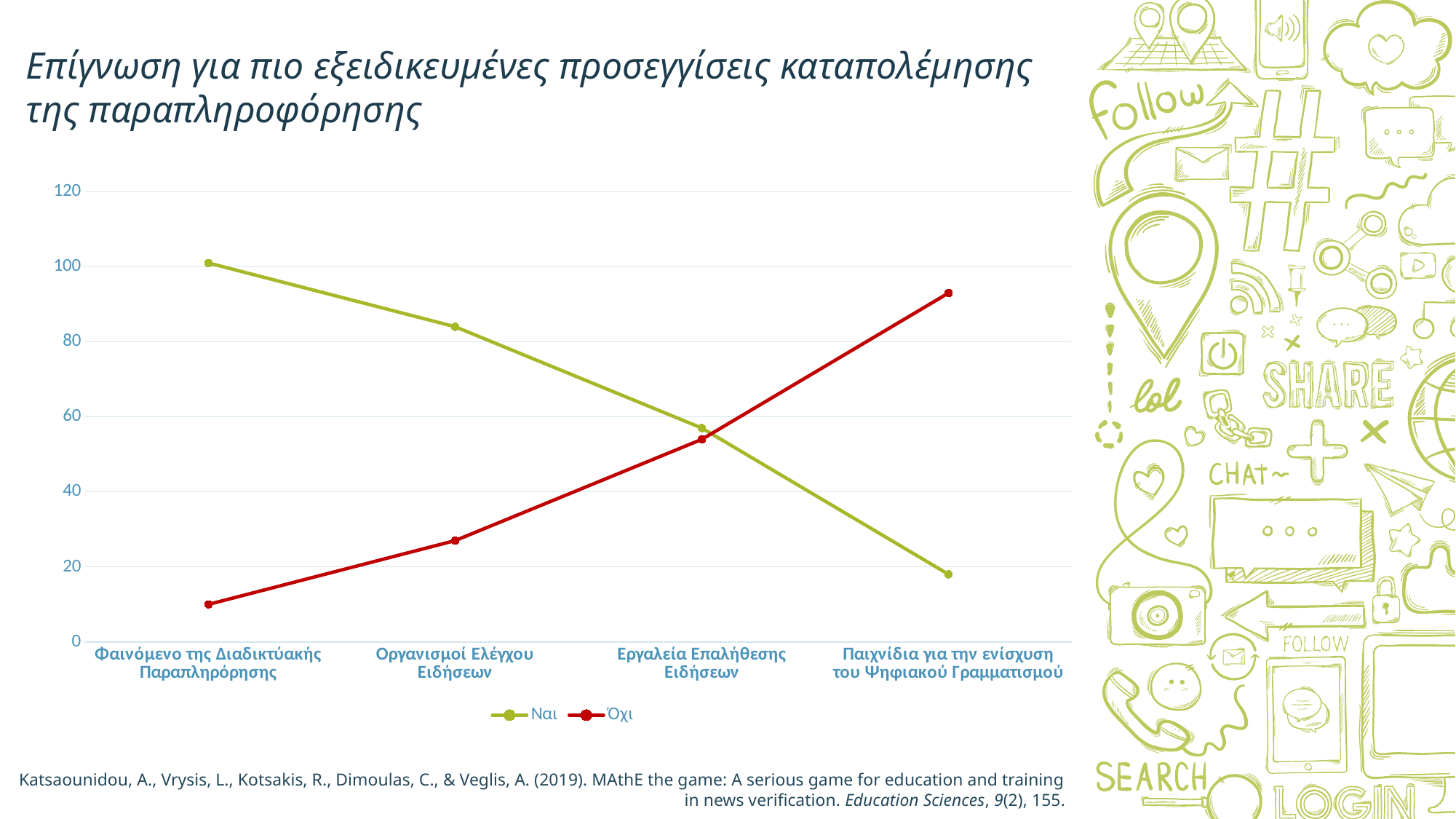
How many categories are shown on the x axis? 4 Is the Όχι value for Οργανισμοί Ελέγχου Ειδήσεων greater or less than 40? less For which category is the Ναι value highest? Φαινόμενο της Διαδικτυακής Παραπληρόρησης For which category is the Όχι value highest? Παιχνίδια για την ενίσχυση του Ψηφιακού Γραμματισμού Which series is shown in green in the legend? Ναι How many series does the legend list? 2 Does the Ναι series rise or fall from left to right along the x axis? fall What kind of chart is shown on the slide? line chart For Παιχνίδια για την ενίσχυση του Ψηφιακού Γραμματισμού, which series has the larger value, Ναι or Όχι? Όχι Does the Όχι series rise or fall from left to right along the x axis? rise For which category is the Όχι value lowest? Φαινόμενο της Διαδικτυακής Παραπληρόρησης